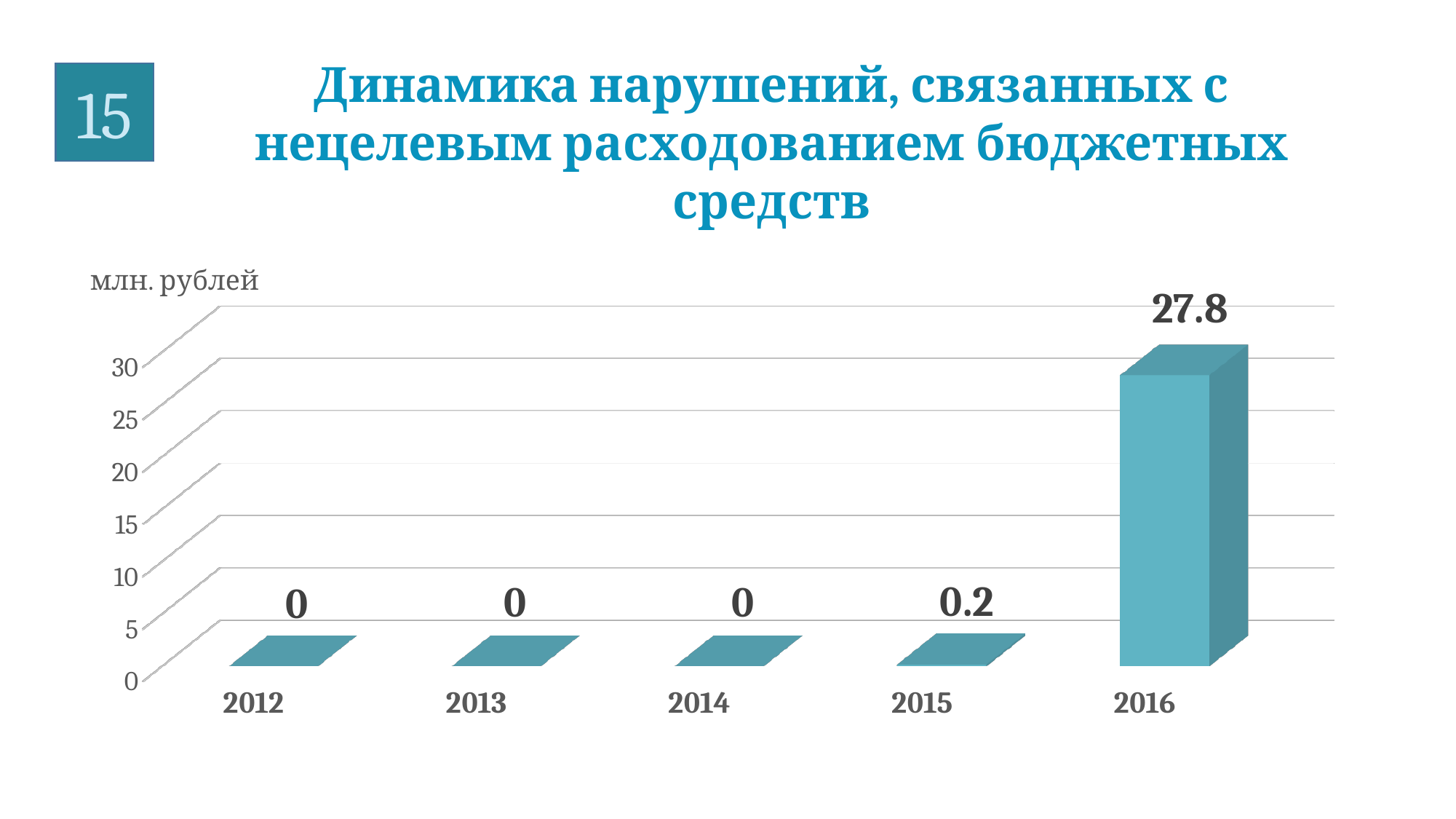
What is the value for 2013? 0 How many years are shown on the x axis? 5 Do the values rise or fall from 2015 to 2016? rise Which year has the highest value? 2016 What is the value for 2015? 0.2 Which is larger, the value for 2015 or the value for 2014? 2015 What is the value for 2016? 27.8 What is the difference between the values for 2016 and 2015? 27.6 What is the title of the chart? Динамика нарушений, связанных с нецелевым расходованием бюджетных средств What unit is shown above the vertical axis? млн. рублей Is the value for 2016 greater or less than 25? greater What kind of chart is shown on the slide? bar chart